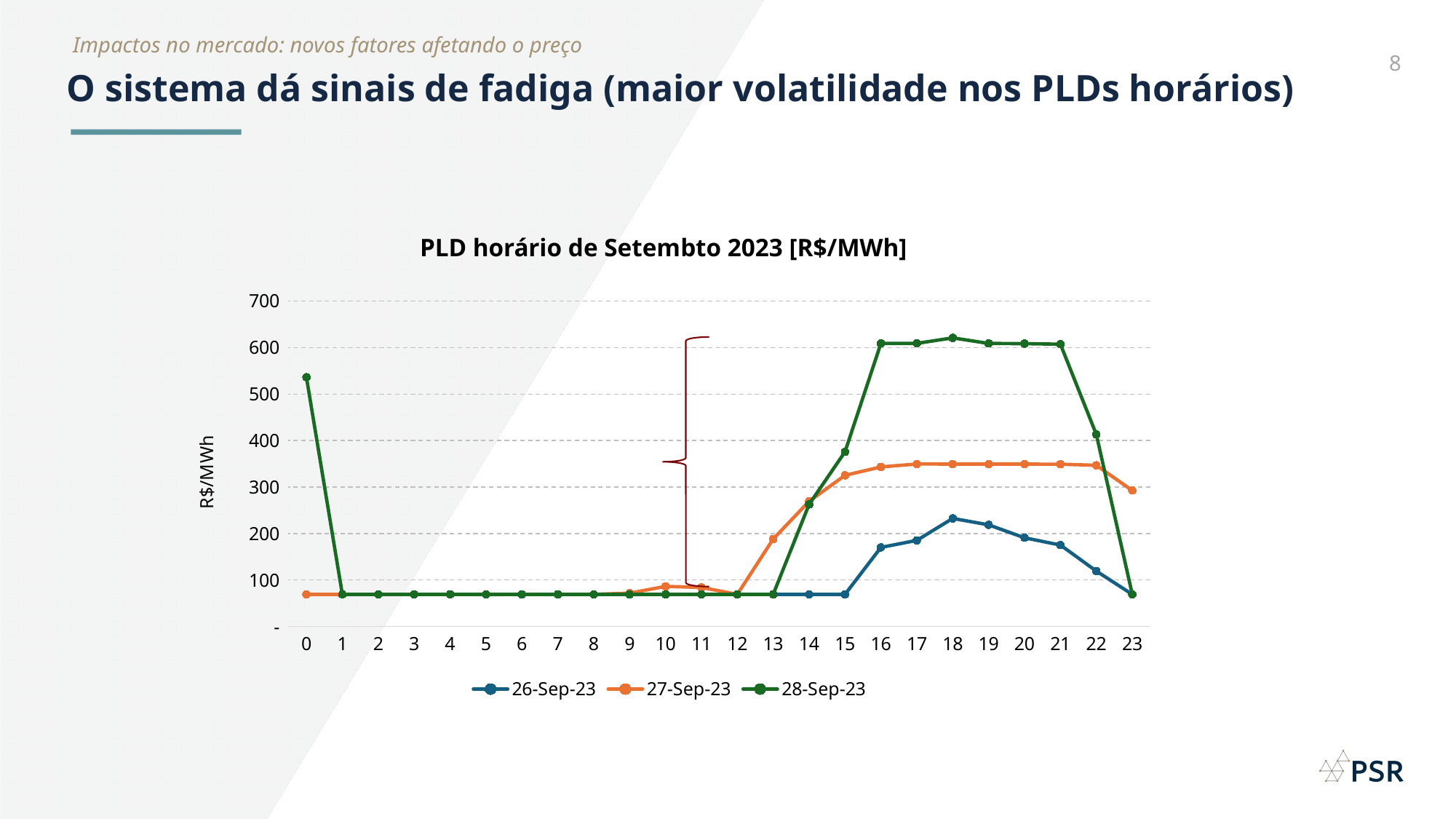
What is the title of the chart? PLD horário de Setembto 2023 [R$/MWh] How many hourly points are plotted along the x axis for each series? 24 What kind of chart is shown on the slide? Line chart Does the 26-Sep-23 series rise or fall from hour 18 to hour 23? Fall Is the value for 26-Sep-23 at hour 23 greater or less than 100? less At hour 15, which series has the larger value, 27-Sep-23 or 28-Sep-23? 28-Sep-23 Is the value for 28-Sep-23 at hour 22 greater or less than 300? greater Which series reaches the highest value on the chart? 28-Sep-23 How many series does the legend list? 3 Is the value for 26-Sep-23 at hour 18 greater or less than 200? greater